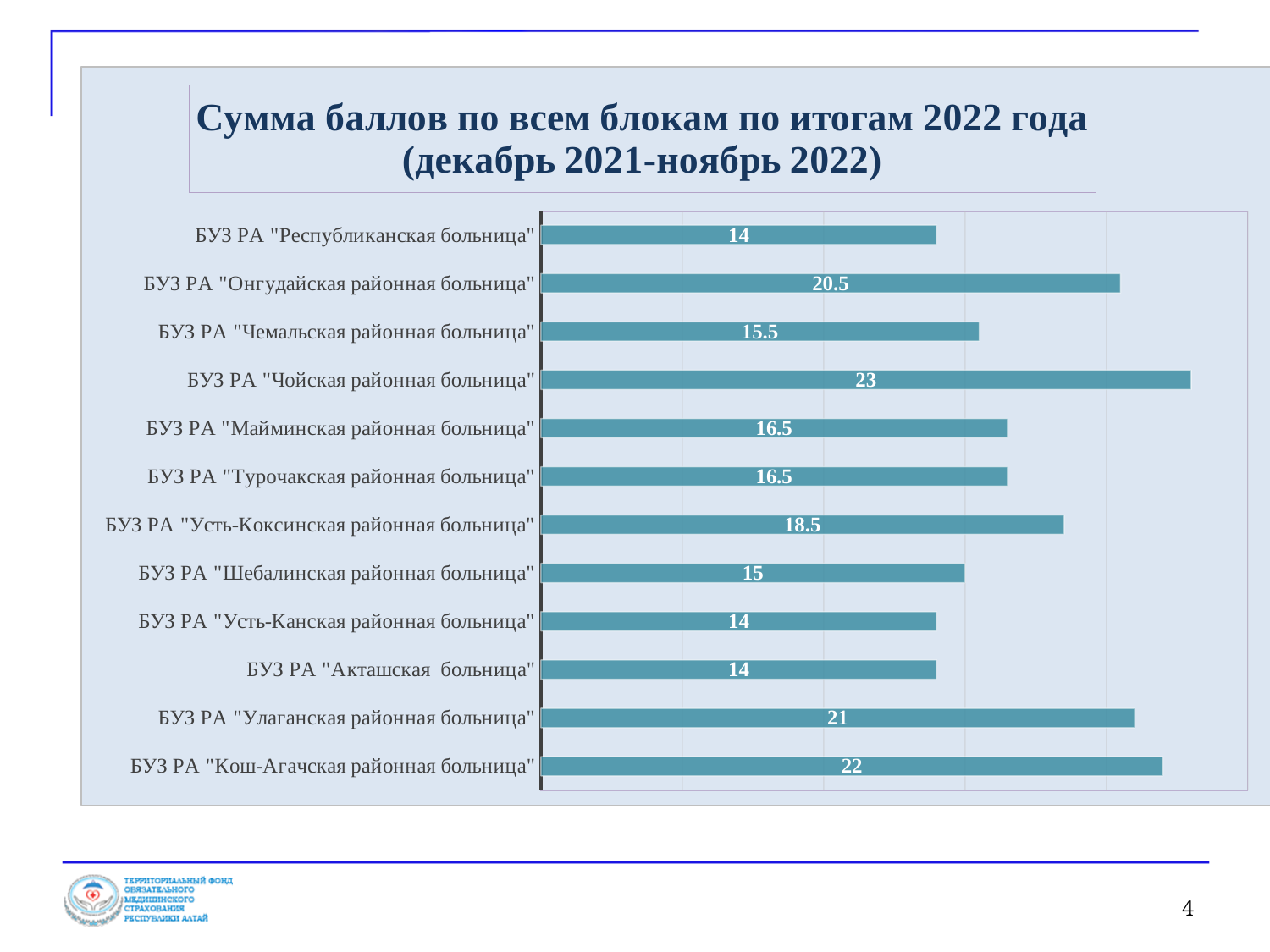
What is the value for БУЗ РА "Усть-Коксинская районная больница"? 18.5 Which hospital has the highest value? БУЗ РА "Чойская районная больница" What is the value for БУЗ РА "Чойская районная больница"? 23 What is the lowest value shown in the chart? 14 How many hospitals are shown in the chart? 12 What is the value for БУЗ РА "Кош-Агачская районная больница"? 22 What type of chart is shown on the slide? Bar chart What is the value for БУЗ РА "Онгудайская районная больница"? 20.5 What is the title of the chart? Сумма баллов по всем блокам по итогам 2022 года (декабрь 2021-ноябрь 2022) What is the difference between the values for БУЗ РА "Кош-Агачская районная больница" and БУЗ РА "Улаганская районная больница"? 1 What is the difference between the values for БУЗ РА "Чойская районная больница" and БУЗ РА "Республиканская больница"? 9 Which is larger, the value for БУЗ РА "Онгудайская районная больница" or БУЗ РА "Чемальская районная больница"? БУЗ РА "Онгудайская районная больница"